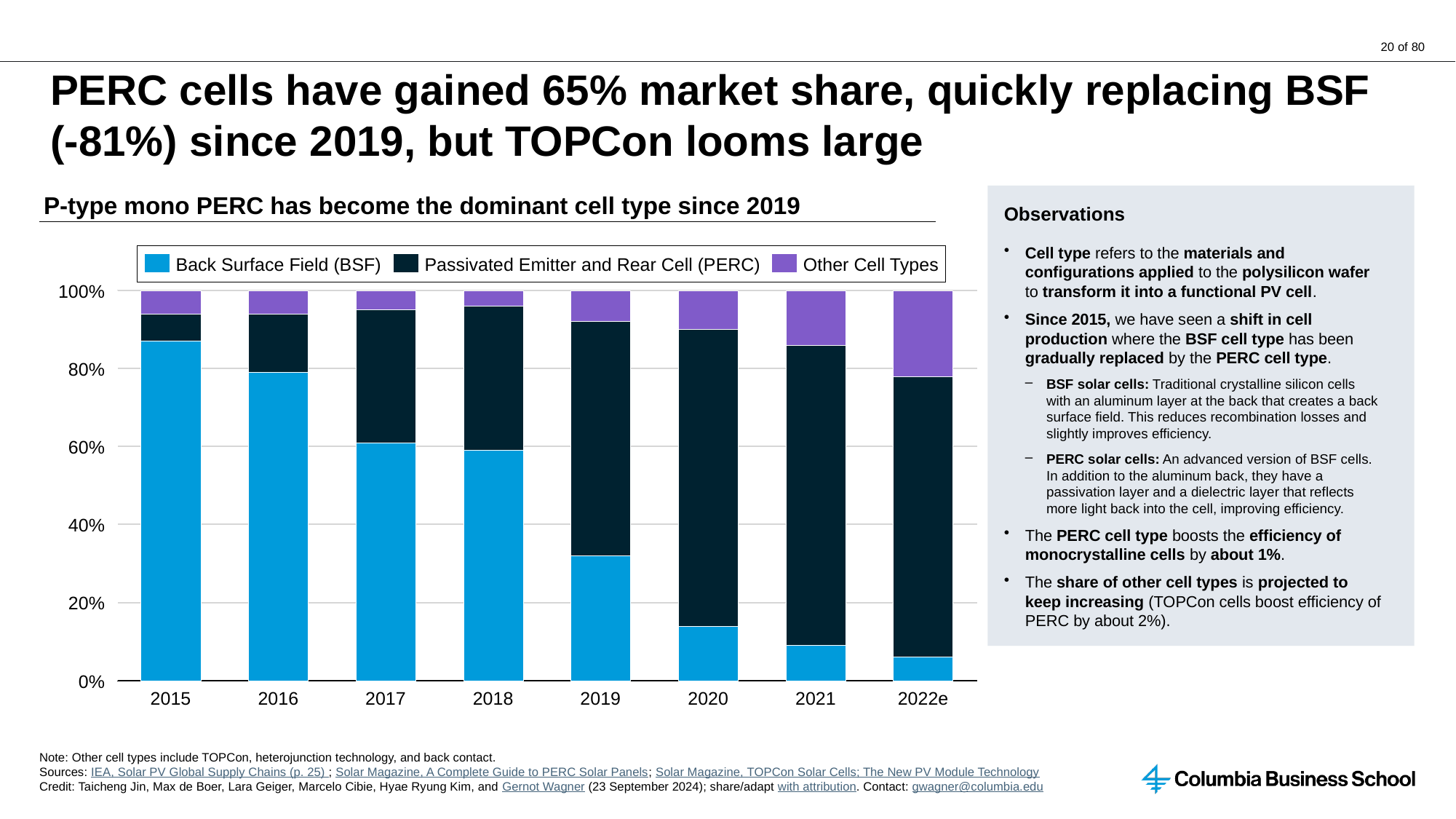
Does the Back Surface Field (BSF) share rise or fall from 2015 to 2022e? fall In which year is the Back Surface Field (BSF) share the highest? 2015 How many series does the chart legend list? 3 Is the Back Surface Field (BSF) share in 2015 greater or less than 80%? greater Is the Back Surface Field (BSF) share in 2020 greater or less than 20%? less Is the Back Surface Field (BSF) share in 2019 greater or less than 40%? less How many years (categories) are shown along the x axis of the chart? 8 What kind of chart is shown on the slide? Stacked bar chart Which year has a larger Back Surface Field (BSF) share, 2016 or 2021? 2016 In which year is the share of Other Cell Types the largest? 2022e What is the title of the chart? P-type mono PERC has become the dominant cell type since 2019 In which year is the Back Surface Field (BSF) share the lowest? 2022e